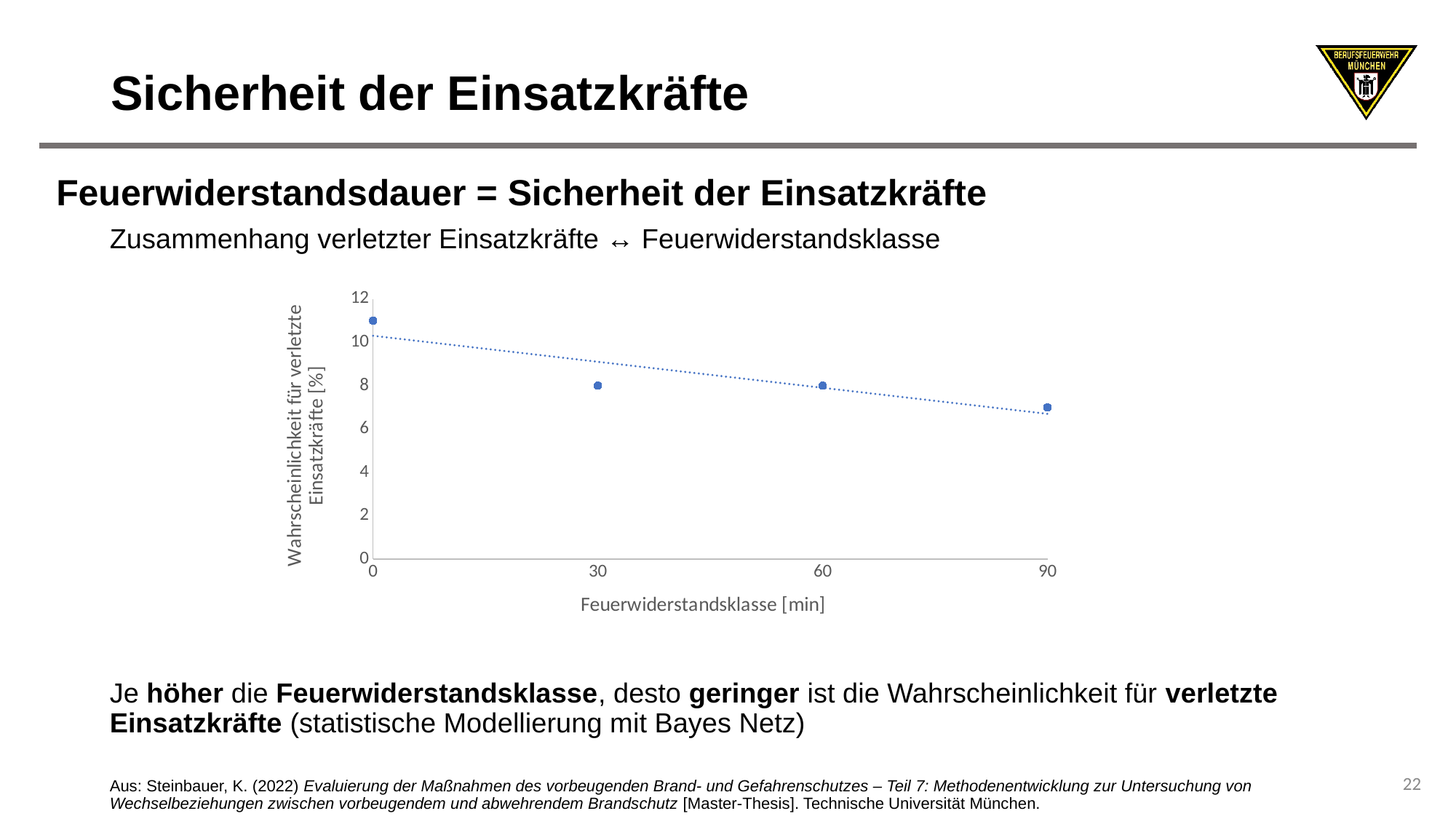
What kind of chart is shown on the slide? scatter chart Which has the larger value: Feuerwiderstandsklasse 0 or Feuerwiderstandsklasse 90? 0 At which Feuerwiderstandsklasse is the probability of injured Einsatzkräfte highest? 0 Is the value at Feuerwiderstandsklasse 0 greater or less than 10? greater Is the value at Feuerwiderstandsklasse 60 greater or less than 6? greater Is the value at Feuerwiderstandsklasse 90 greater or less than 8? less What is the label of the y axis of the chart? Wahrscheinlichkeit für verletzte Einsatzkräfte [%] What is the label of the x axis of the chart? Feuerwiderstandsklasse [min] At which Feuerwiderstandsklasse is the probability of injured Einsatzkräfte lowest? 90 How many data points are plotted in the chart? 4 Do the values rise or fall as the Feuerwiderstandsklasse increases along the x axis? fall